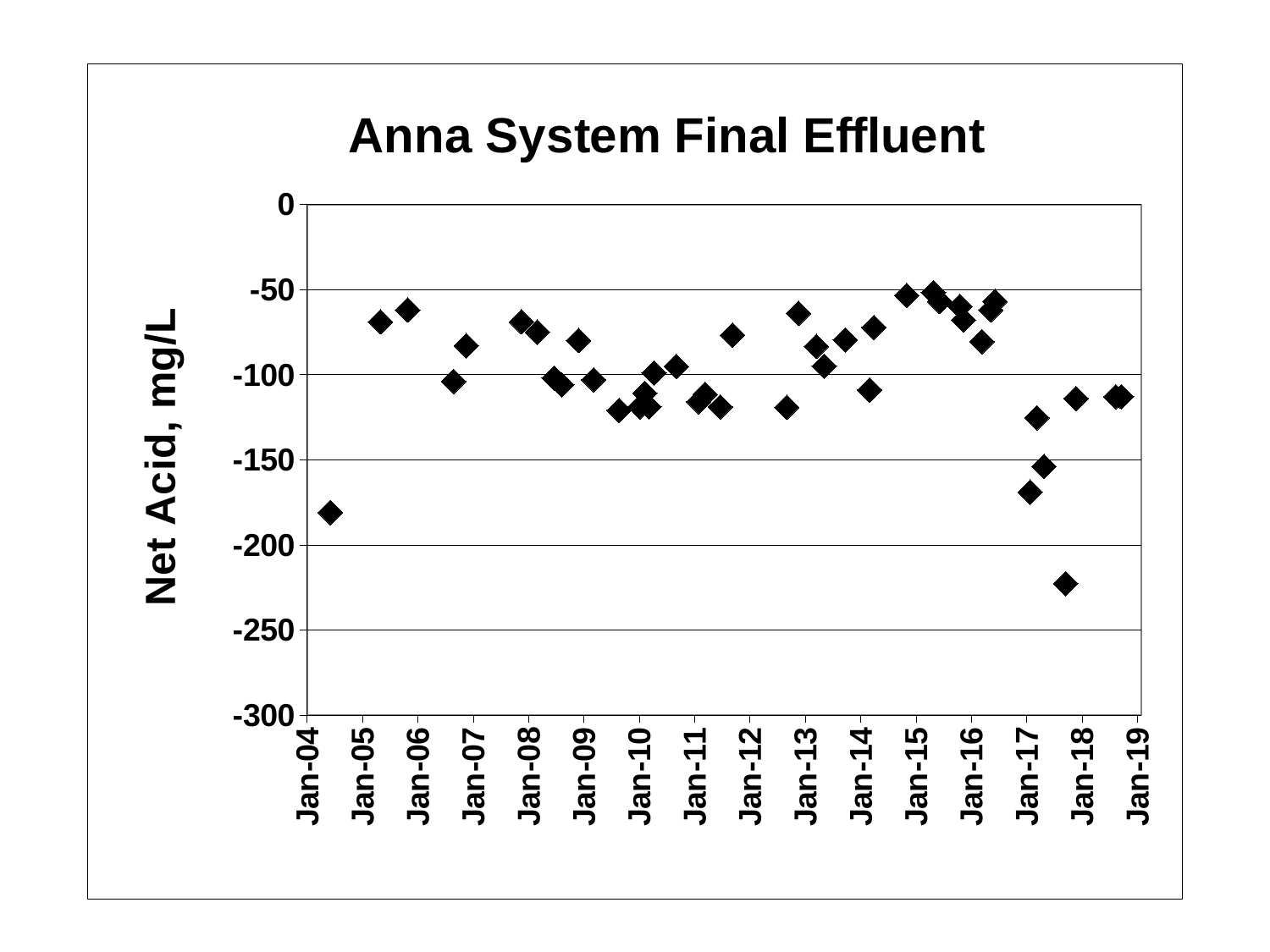
Is the lowest plotted value (between Jan-17 and Jan-18) greater or less than -200? less Is the value plotted just after Jan-15 greater or less than -100? greater Is the value plotted just before Jan-10 greater or less than -100? less Between the first point (just after Jan-04) and the points in 2005, do the values rise or fall? rise Which is larger: the value plotted just after Jan-04 or the values plotted between Jan-05 and Jan-06? the values between Jan-05 and Jan-06 What kind of chart is shown on the slide? scatter chart What is the label on the vertical axis of the chart? Net Acid, mg/L In which period does the lowest plotted value occur? between Jan-17 and Jan-18 What is the title of the chart? Anna System Final Effluent Which is larger: the value plotted just after Jan-04 or the lowest value plotted between Jan-17 and Jan-18? the value just after Jan-04